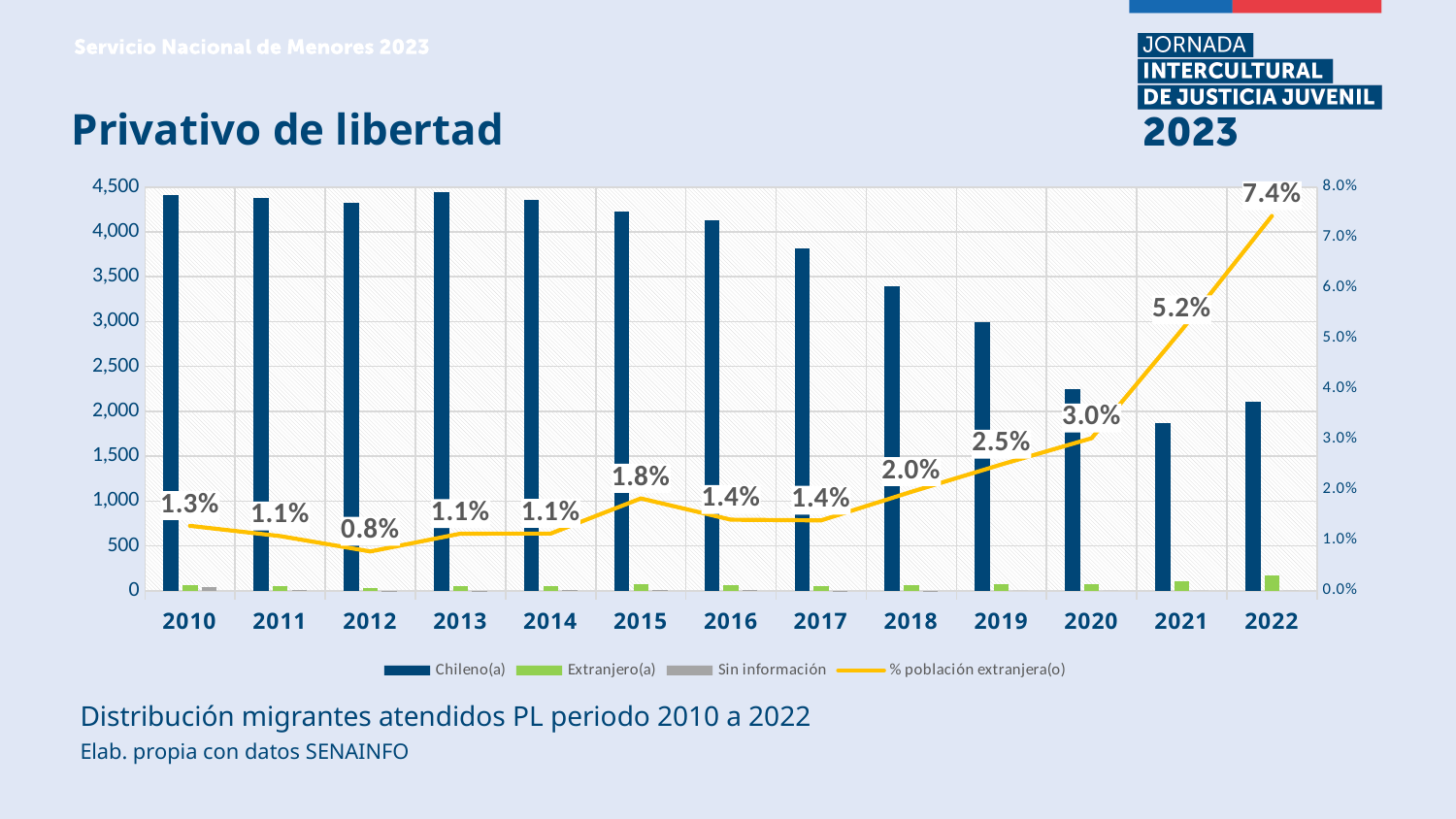
Which year has a higher % población extranjera(o), 2015 or 2016? 2015 What is the value of % población extranjera(o) for 2022? 7.4% Is the Chileno(a) value for 2021 greater or less than 2,000? less In which year is % población extranjera(o) lowest? 2012 Is the Chileno(a) value for 2010 greater or less than 4,000? greater What is the value of % población extranjera(o) for 2019? 2.5% How many years are shown on the x axis? 13 Does the % población extranjera(o) line generally rise or fall from 2010 to 2022? rise How many series does the legend list? 4 What is the difference between % población extranjera(o) in 2022 and in 2021? 2.2 percentage points In which year is % población extranjera(o) highest? 2022 What is the value of % población extranjera(o) for 2012? 0.8%